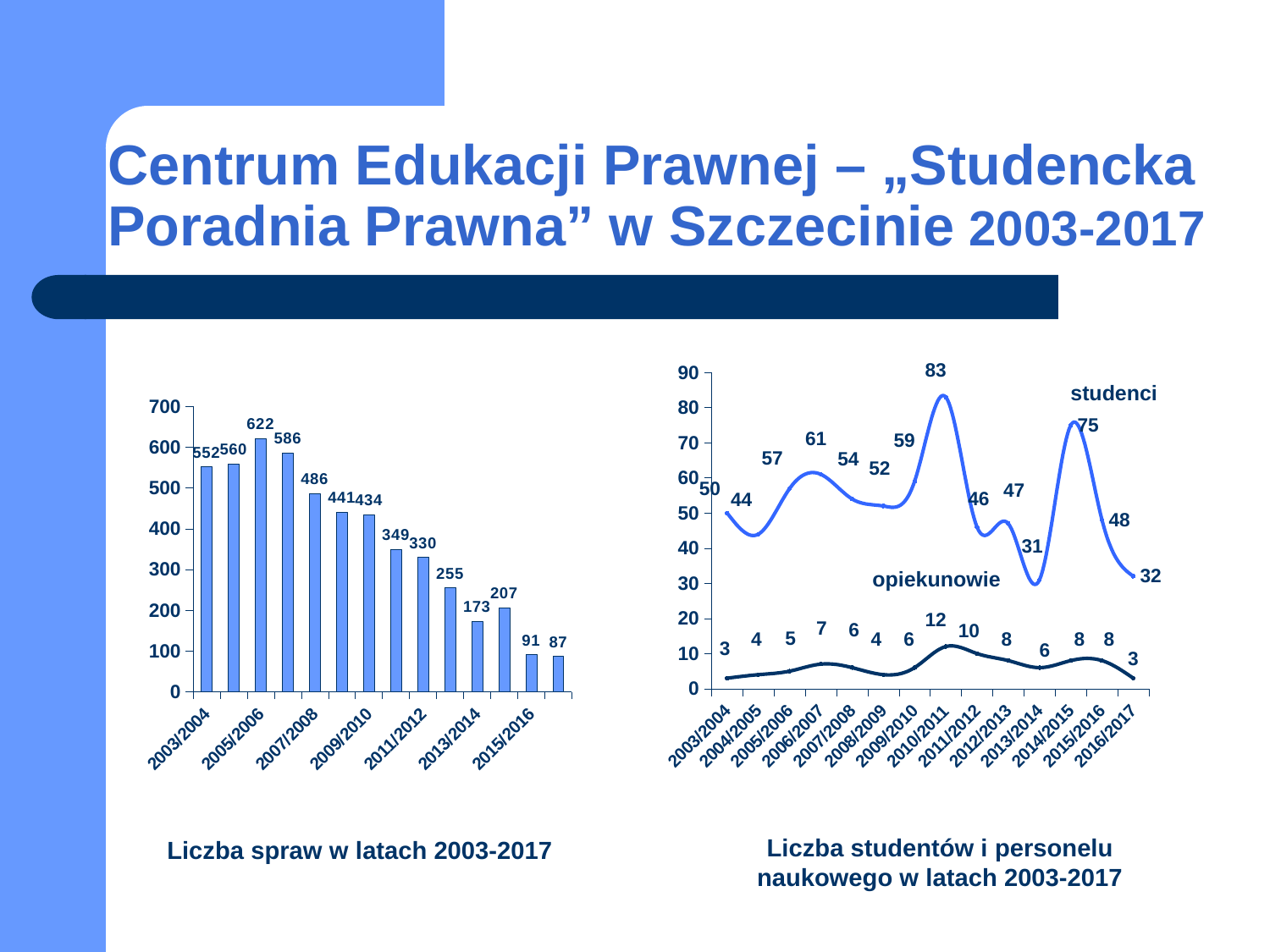
In the right chart (Liczba studentów i personelu naukowego), what is the studenci value for 2010/2011? 83 In the right chart (Liczba studentów i personelu naukowego), what is the opiekunowie value for 2016/2017? 3 In the left chart (Liczba spraw w latach 2003-2017), do the values generally rise or fall from 2005/2006 onward? fall In the left chart (Liczba spraw w latach 2003-2017), what kind of chart is shown? bar chart In the right chart (Liczba studentów i personelu naukowego), how many series are plotted? 2 In the right chart (Liczba studentów i personelu naukowego), which is larger, the studenci value for 2014/2015 or for 2015/2016? 2014/2015 In the left chart (Liczba spraw w latach 2003-2017), what is the value for 2003/2004? 552 In the left chart (Liczba spraw w latach 2003-2017), what is the value for 2005/2006? 622 In the left chart (Liczba spraw w latach 2003-2017), what is the difference between the values for 2007/2008 and 2009/2010? 52 In the left chart (Liczba spraw w latach 2003-2017), which year has the highest value? 2005/2006 In the right chart (Liczba studentów i personelu naukowego), in which year is the studenci value lowest? 2013/2014 In the left chart (Liczba spraw w latach 2003-2017), what is the value for 2013/2014? 173